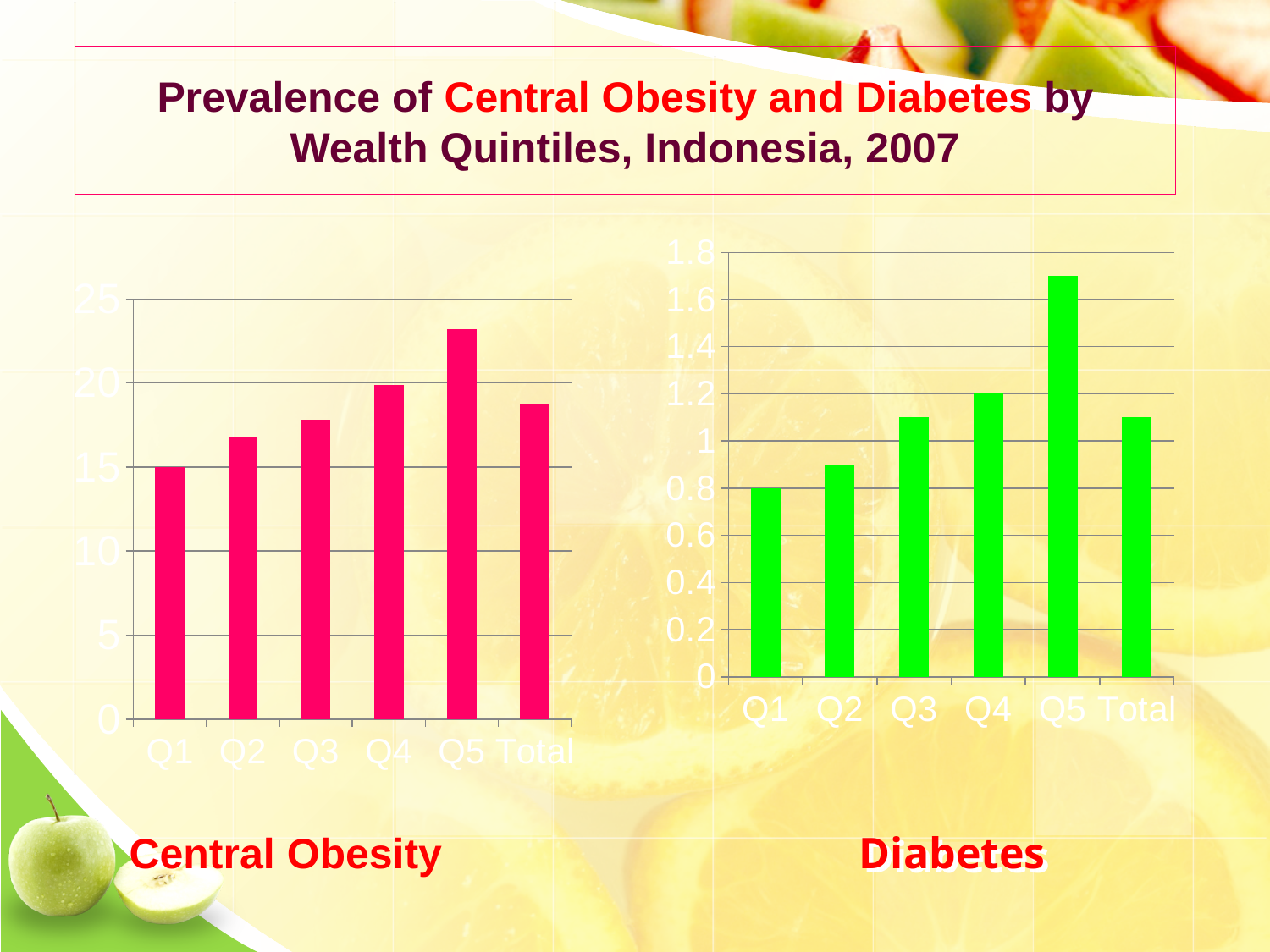
In the Central Obesity chart, which category has the highest bar? Q5 What kind of chart is the Central Obesity chart on the left? bar chart In the Diabetes chart, is the value for Q2 greater or less than 1? less In the Diabetes chart, which category has the lowest bar? Q1 In the Central Obesity chart, which category has the lowest bar? Q1 In the Diabetes chart, what is the value for Q1? 0.8 In the Central Obesity chart, do the values rise or fall from Q1 to Q5? rise In the Diabetes chart, which is larger, the value for Q4 or the value for Q2? Q4 In the Central Obesity chart, is the value for Q5 greater or less than 20? greater In the Diabetes chart, which category has the highest bar? Q5 How many categories are shown on the x axis of the Central Obesity chart? 6 In the Diabetes chart, is the value for Q5 greater or less than 1.6? greater